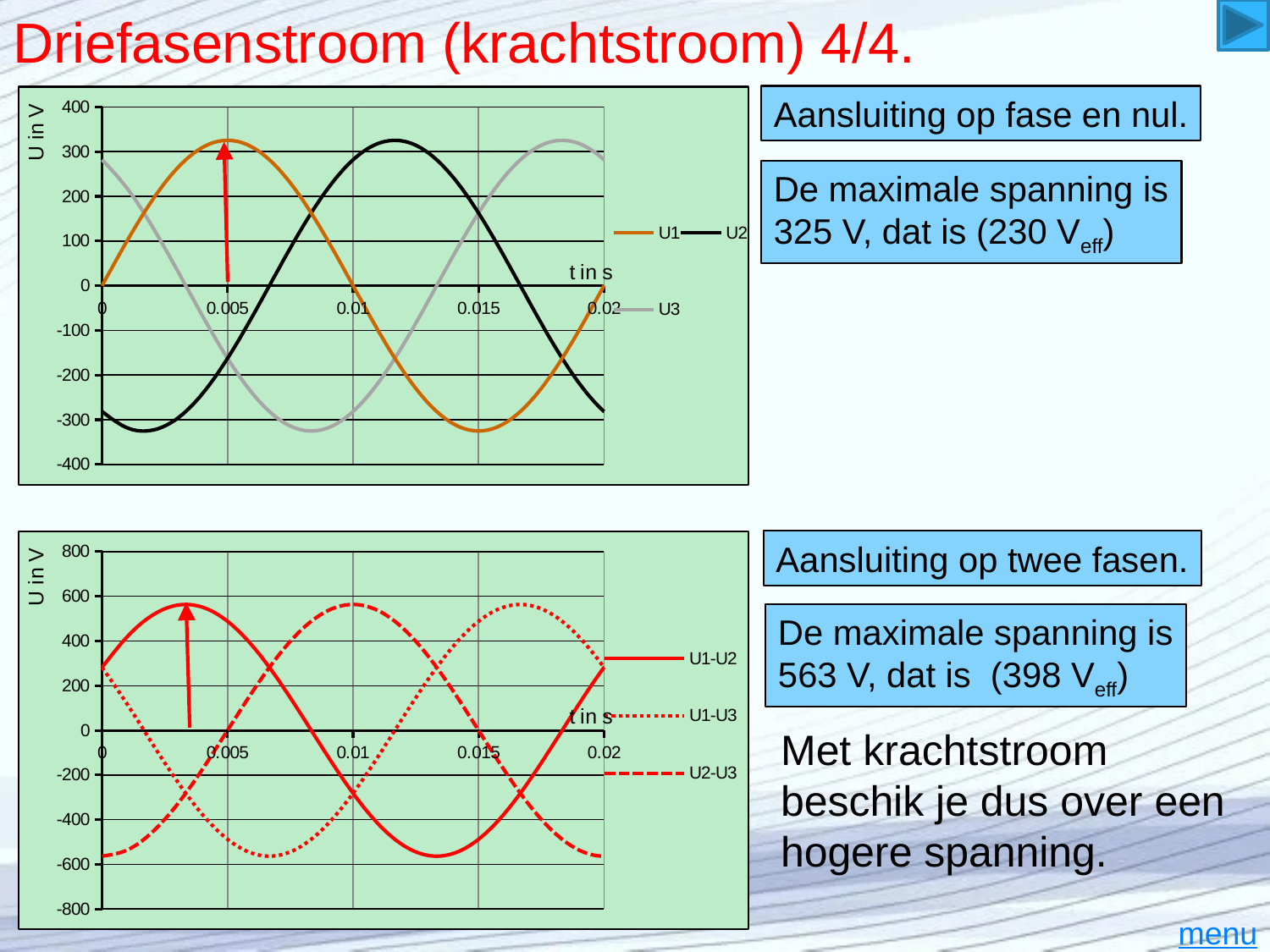
What is the highest value shown on the vertical axis of the bottom chart? 800 In the top chart, is the value of U2 at t = 0 greater or less than -200? less In the top chart, what is the value of U1 at t = 0? 0 In the bottom chart, is the value of U2-U3 at t = 0 greater or less than -400? less What kind of chart is the top chart on the slide? line chart How many series does the legend of the top chart list? 3 In the top chart, does the value of U1 rise or fall between t = 0 and t = 0.005? rise In the top chart, is the peak value of U1 near t = 0.005 greater or less than 300? greater How many series does the legend of the bottom chart list? 3 In the bottom chart, does the value of U1-U2 rise or fall between t = 0.005 and t = 0.01? fall Which series in the bottom chart is drawn as a solid line? U1-U2